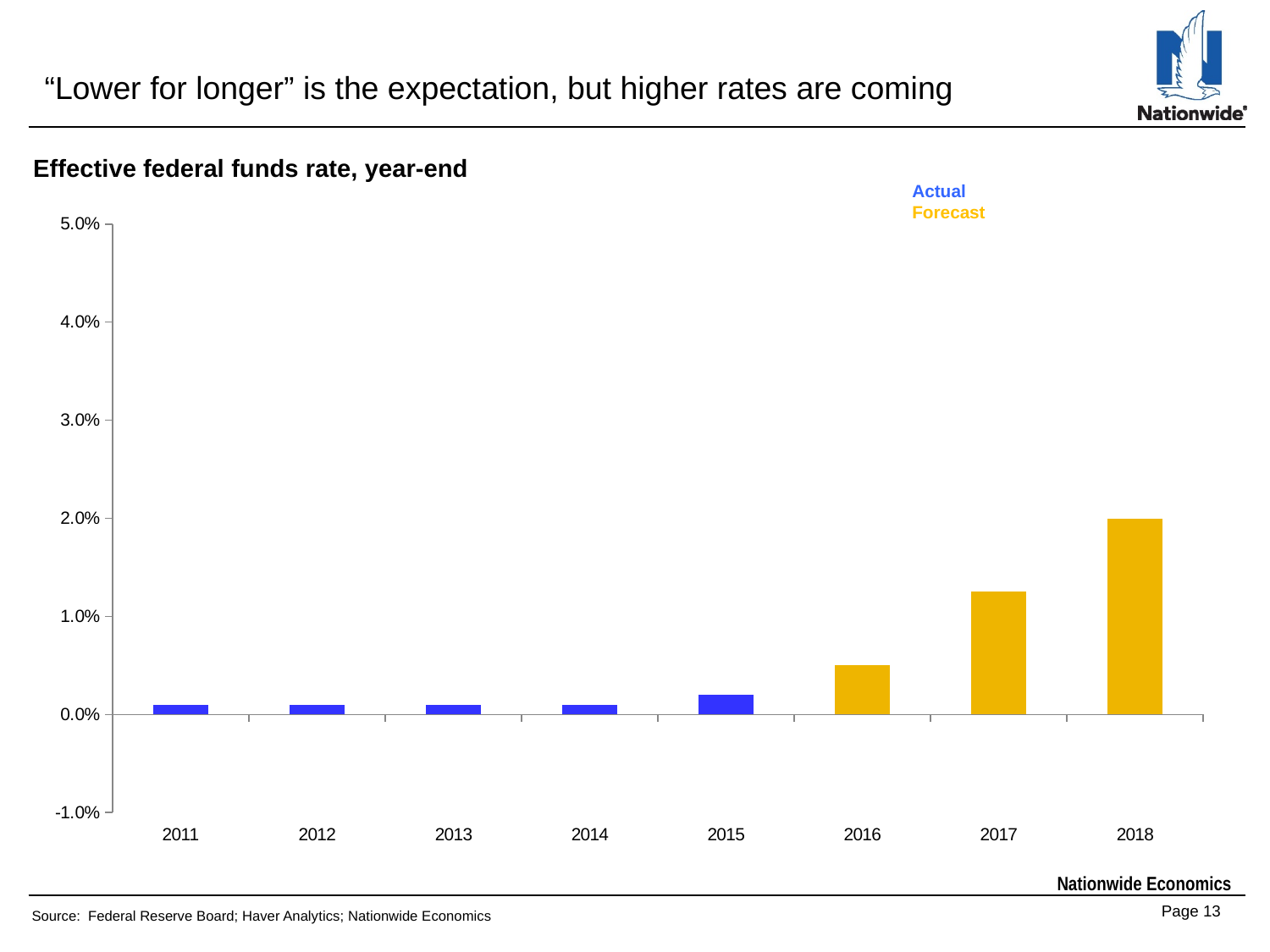
Which is larger, the value for 2017 or the value for 2016? 2017 Which legend entry is shown in gold/yellow? Forecast Do the values generally rise or fall from 2015 to 2018? rise Which year has the highest effective federal funds rate in the chart? 2018 What is the title of the chart? Effective federal funds rate, year-end How many years are shown on the x axis of the chart? 8 What type of chart is shown on the slide? bar chart Is the value for 2018 greater or less than 1.0%? greater How many series does the chart's legend list? 2 Is the value for 2015 greater or less than 1.0%? less Is the value for 2016 greater or less than 1.0%? less